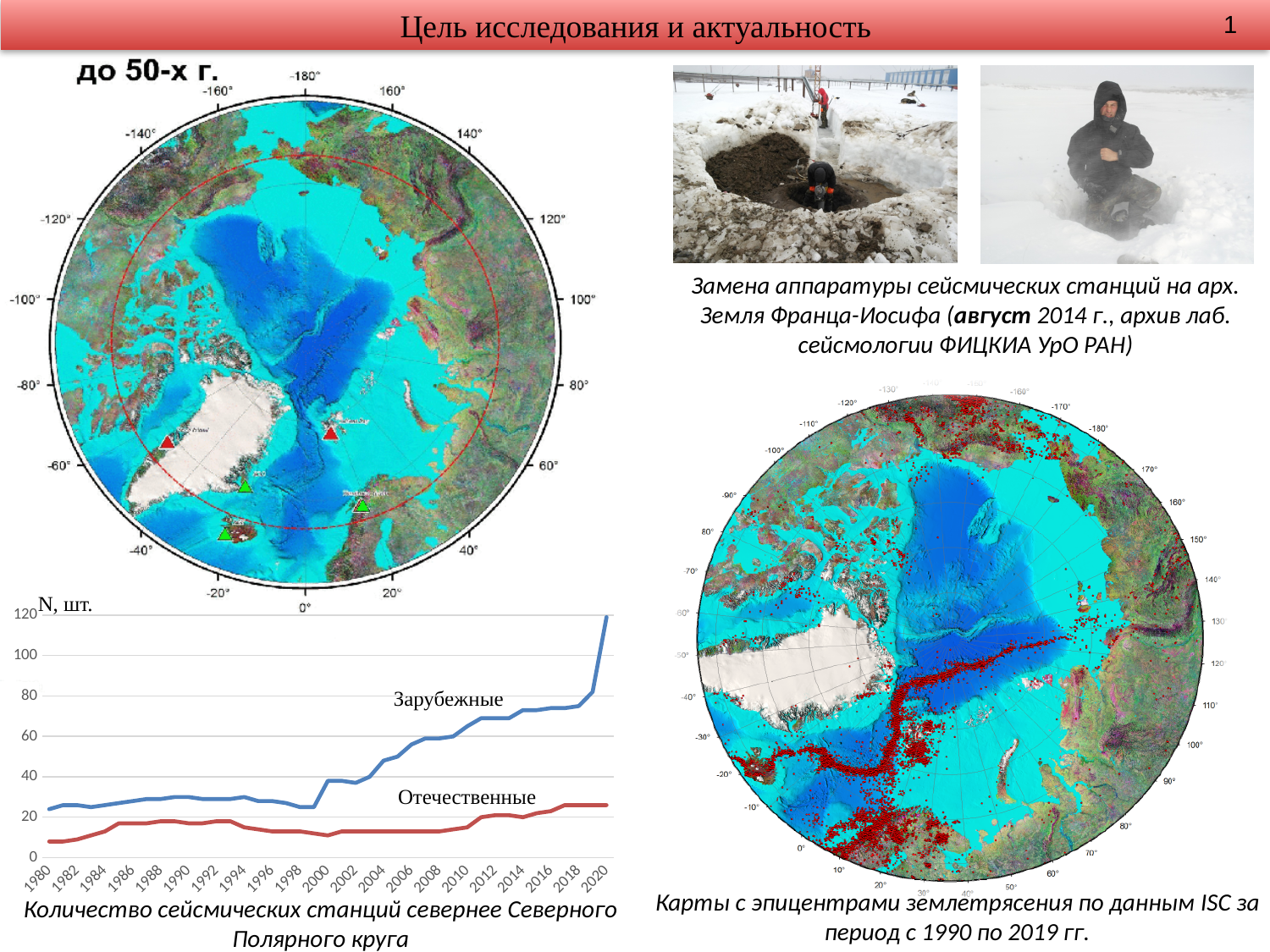
In the line chart, is the value of Отечественные in 1980 greater or less than 20? less In the line chart, does the Зарубежные series generally rise or fall from 1980 to 2020? rise In the line chart, what are the names of the two plotted series? Зарубежные and Отечественные How many data series are plotted in the line chart at the bottom left? 2 In the line chart, is the value of Зарубежные in 1980 greater or less than 40? less In the line chart, is the value of Отечественные in 2020 greater or less than 40? less What is the label on the vertical axis of the line chart? N, шт. What kind of chart is shown at the bottom left of the slide? line chart Which series in the line chart reaches the highest value overall? Зарубежные In the line chart, which series reaches the higher value in 2020, Зарубежные or Отечественные? Зарубежные